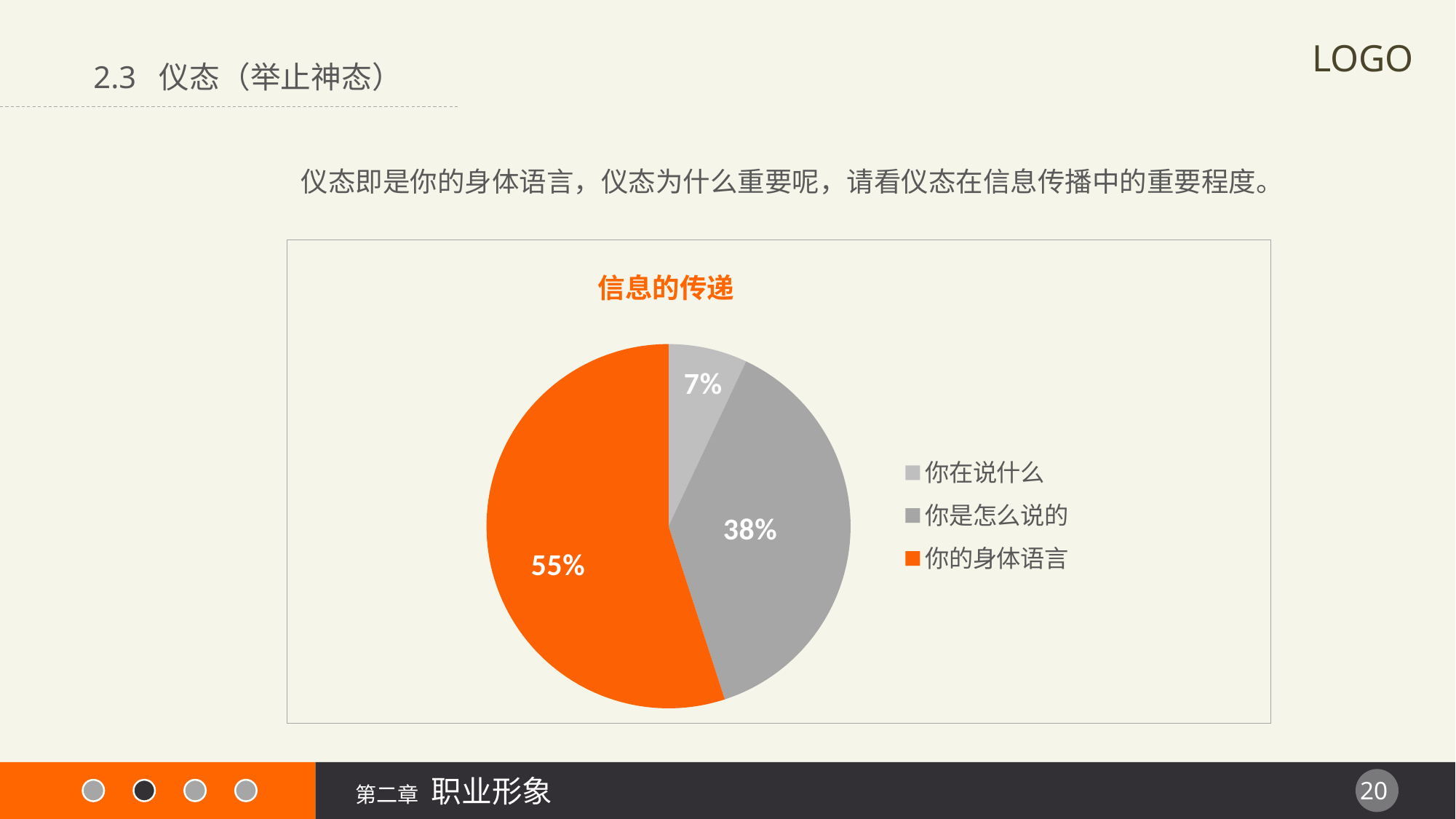
Which category has the smallest slice? 你在说什么 What is the difference between the values for 你的身体语言 and 你是怎么说的? 17% What is the difference between the values for 你是怎么说的 and 你在说什么? 31% What colour is the slice for 你的身体语言? orange Which is larger, the slice for 你是怎么说的 or the slice for 你在说什么? 你是怎么说的 Which category has the largest slice? 你的身体语言 What kind of chart is shown on the slide? pie chart What is the value for 你在说什么? 7% What share of the pie does 你的身体语言 take? 55% What is the title of the chart? 信息的传递 How many slices does the pie chart have? 3 What is the value for 你是怎么说的? 38%